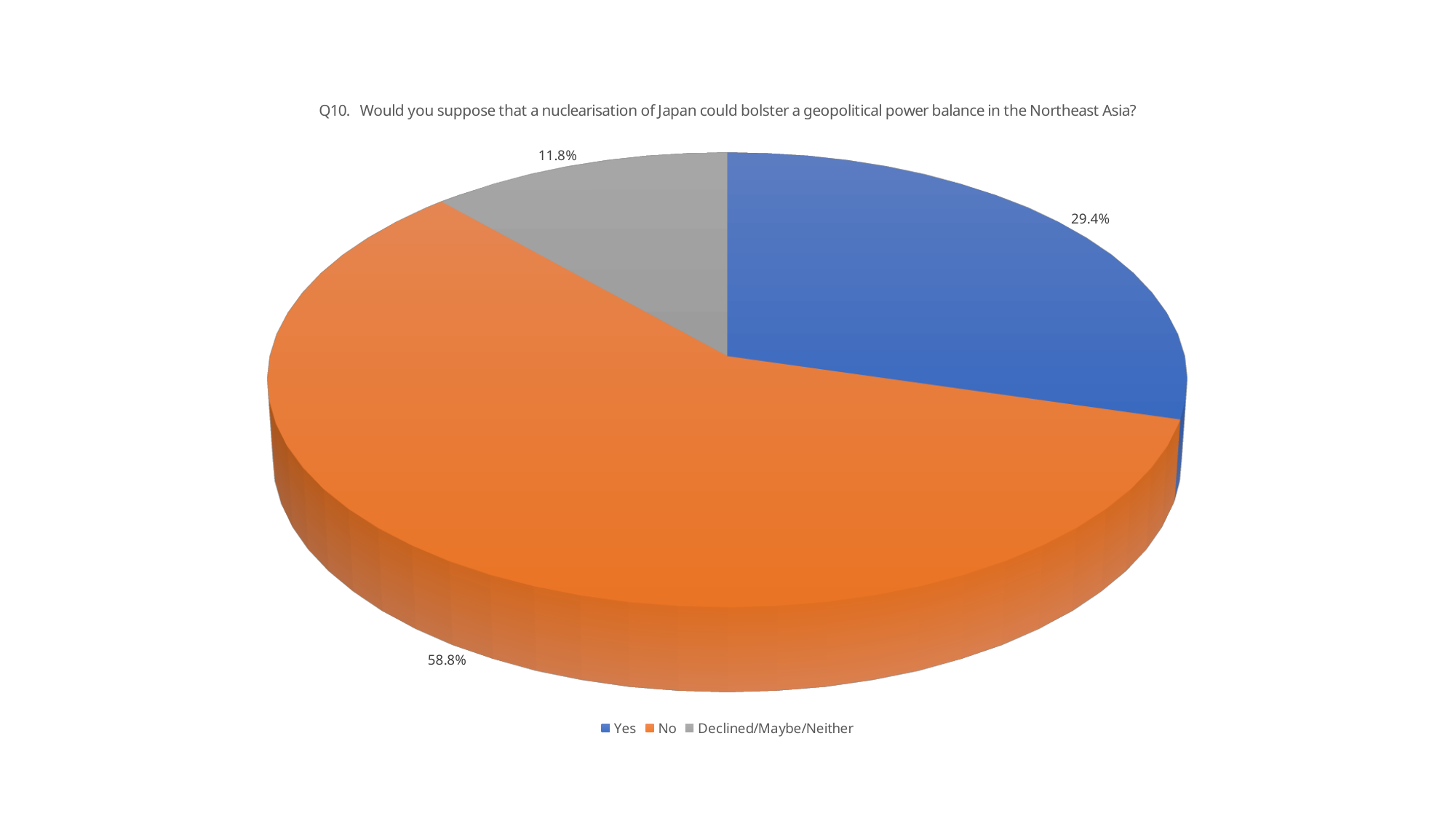
How many slices does the pie chart have? 3 What is the difference in percentage points between the "No" and "Yes" shares? 29.4 What percentage of respondents answered "No"? 58.8% What is the question number shown in the chart title? Q10 What percentage of respondents answered "Declined/Maybe/Neither"? 11.8% Which response has the smallest share of the pie? Declined/Maybe/Neither Which is larger, the share for "Yes" or the share for "Declined/Maybe/Neither"? Yes What percentage of respondents answered "Yes"? 29.4% What kind of chart is shown on the slide? Pie chart Which response has the largest share of the pie? No What colour is the slice representing "No"? Orange How many entries does the legend list? 3